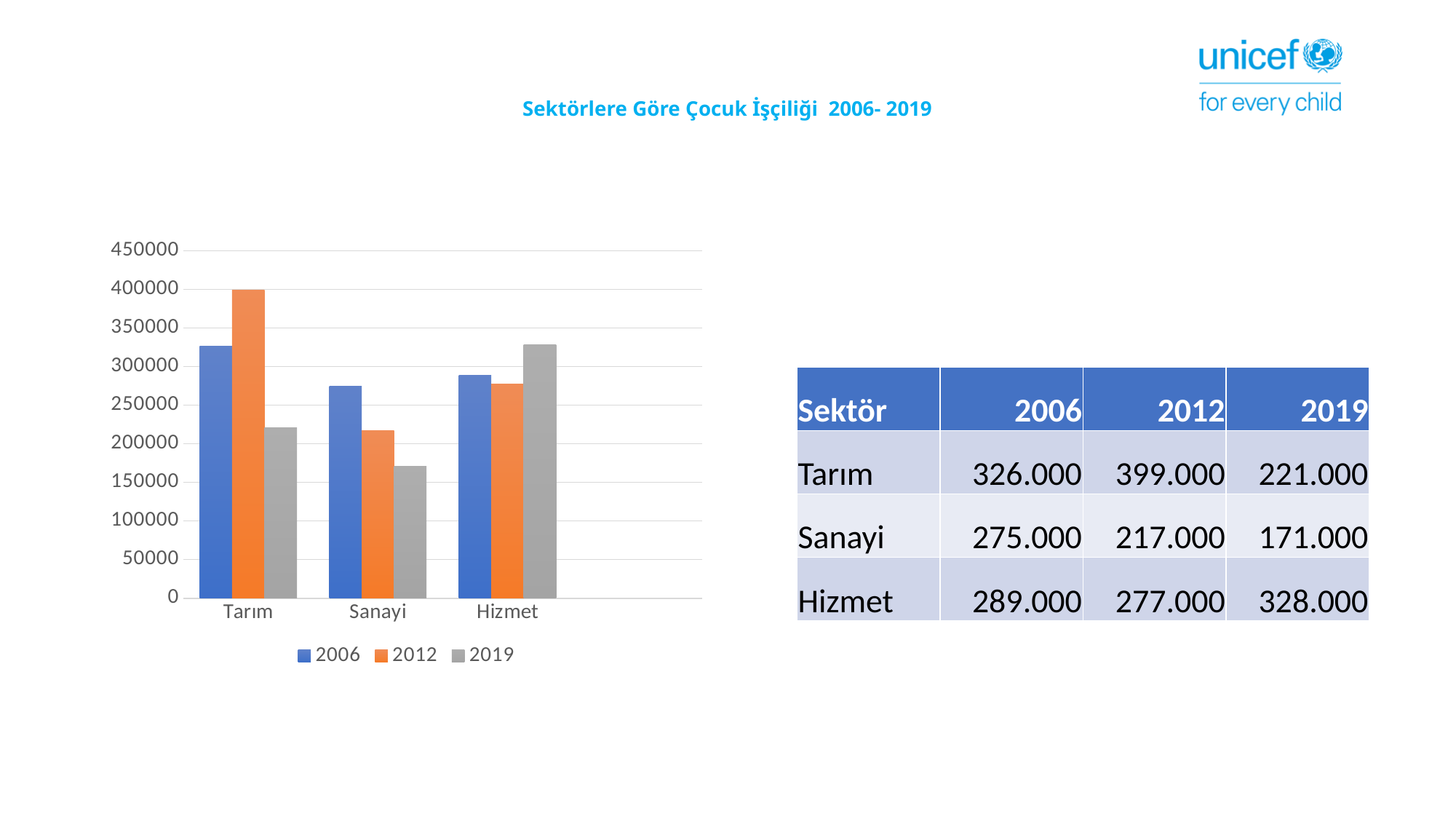
What is the difference between the 2006 and 2019 values for Tarım? 105.000 Which is larger: the 2006 value for Hizmet or the 2012 value for Hizmet? 2006 Do the values for Sanayi rise or fall from 2006 to 2019? fall Which category has the highest value in the 2012 series? Tarım What is the value for Tarım in 2012? 399.000 What is the value for Sanayi in 2006? 275.000 How many categories are shown on the x axis of the chart? 3 What is the value for Hizmet in 2019? 328.000 Is the value for Sanayi in 2019 greater or less than 200000? less How many series does the chart legend list? 3 What kind of chart is shown on the slide? bar chart Which category has the lowest value in the 2019 series? Sanayi